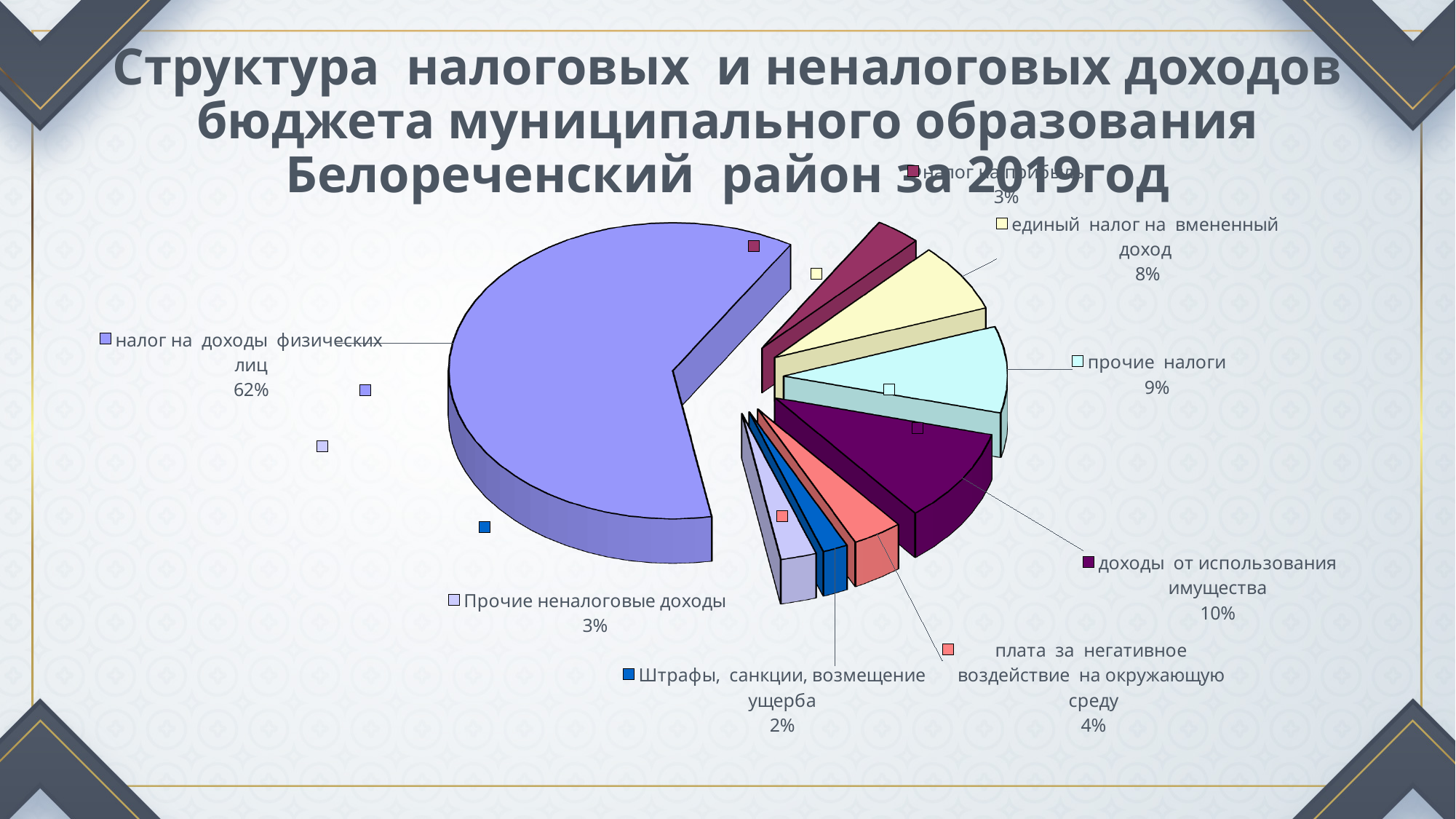
Which is larger: the share for "прочие налоги" or the share for "Прочие неналоговые доходы"? прочие налоги For which year does the slide title say the revenue structure is shown? 2019 What percentage is shown for "доходы от использования имущества"? 10% What percentage is shown for "плата за негативное воздействие на окружающую среду"? 4% How many slices does the pie chart have? 8 Which category has the smallest share of the pie? Штрафы, санкции, возмещение ущерба What is the difference in percentage points between "доходы от использования имущества" and "единый налог на вмененный доход"? 2 What share of the pie does "налог на доходы физических лиц" have? 62% Which category has the largest share of the pie? налог на доходы физических лиц What percentage is shown for "единый налог на вмененный доход"? 8% What percentage is shown for "прочие налоги"? 9% What kind of chart is shown on the slide? pie chart